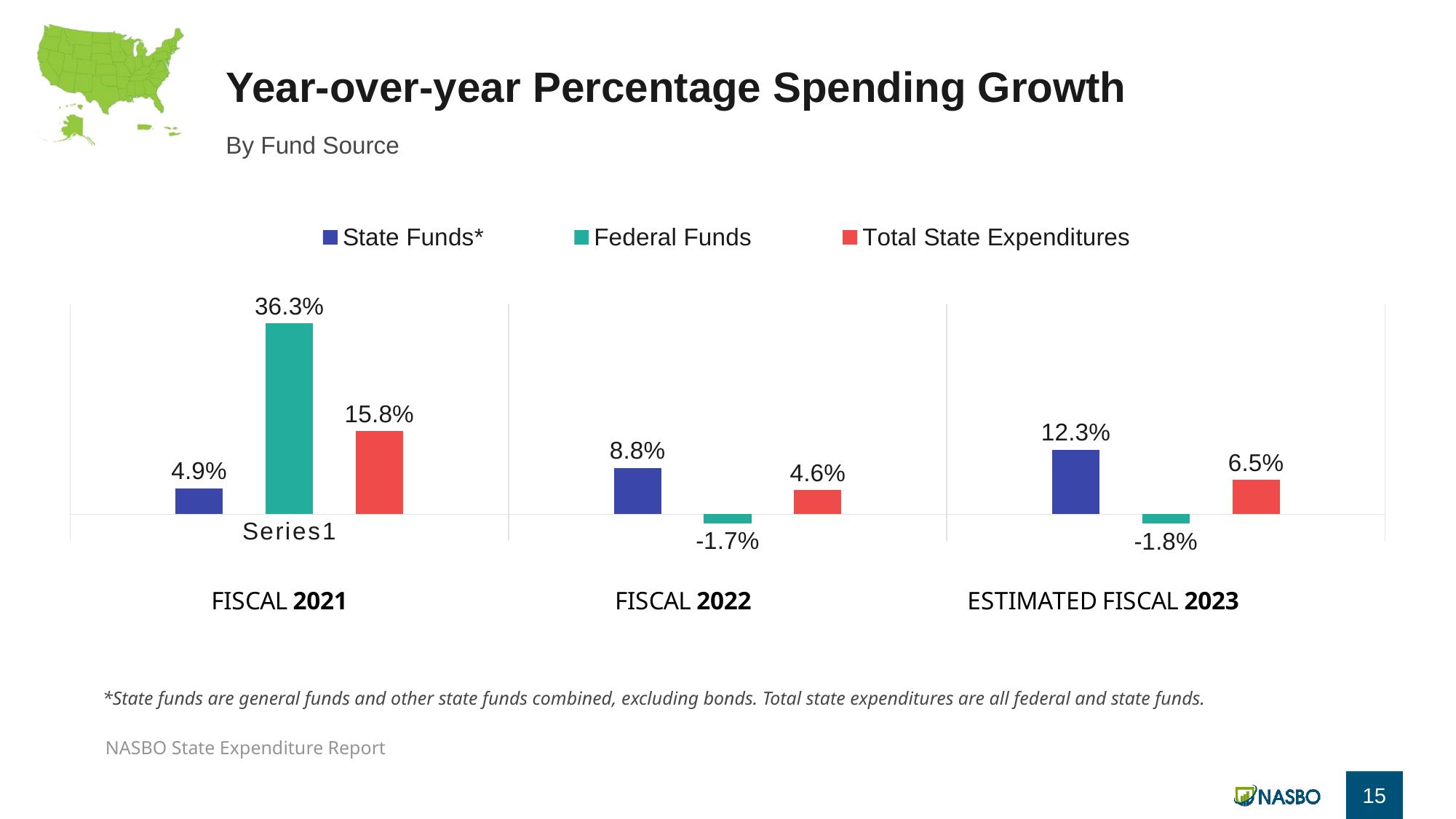
What colour represents Total State Expenditures in the legend? Red Which fund source has the lowest growth in Estimated Fiscal 2023? Federal Funds What kind of chart is used on this slide? Bar chart What is the year-over-year growth in Federal Funds for Fiscal 2022? -1.7% What is the difference between the Federal Funds growth and the State Funds* growth in Fiscal 2021? 31.4% How many fiscal year groups are shown on the slide? 3 What is the year-over-year growth in Total State Expenditures for Fiscal 2022? 4.6% Which is larger in Fiscal 2022: the growth in State Funds* or the growth in Total State Expenditures? State Funds* How many series does the legend list? 3 What is the year-over-year growth in Federal Funds for Fiscal 2021? 36.3% What is the year-over-year growth in State Funds* for Estimated Fiscal 2023? 12.3% Which fund source has the highest growth in Fiscal 2021? Federal Funds